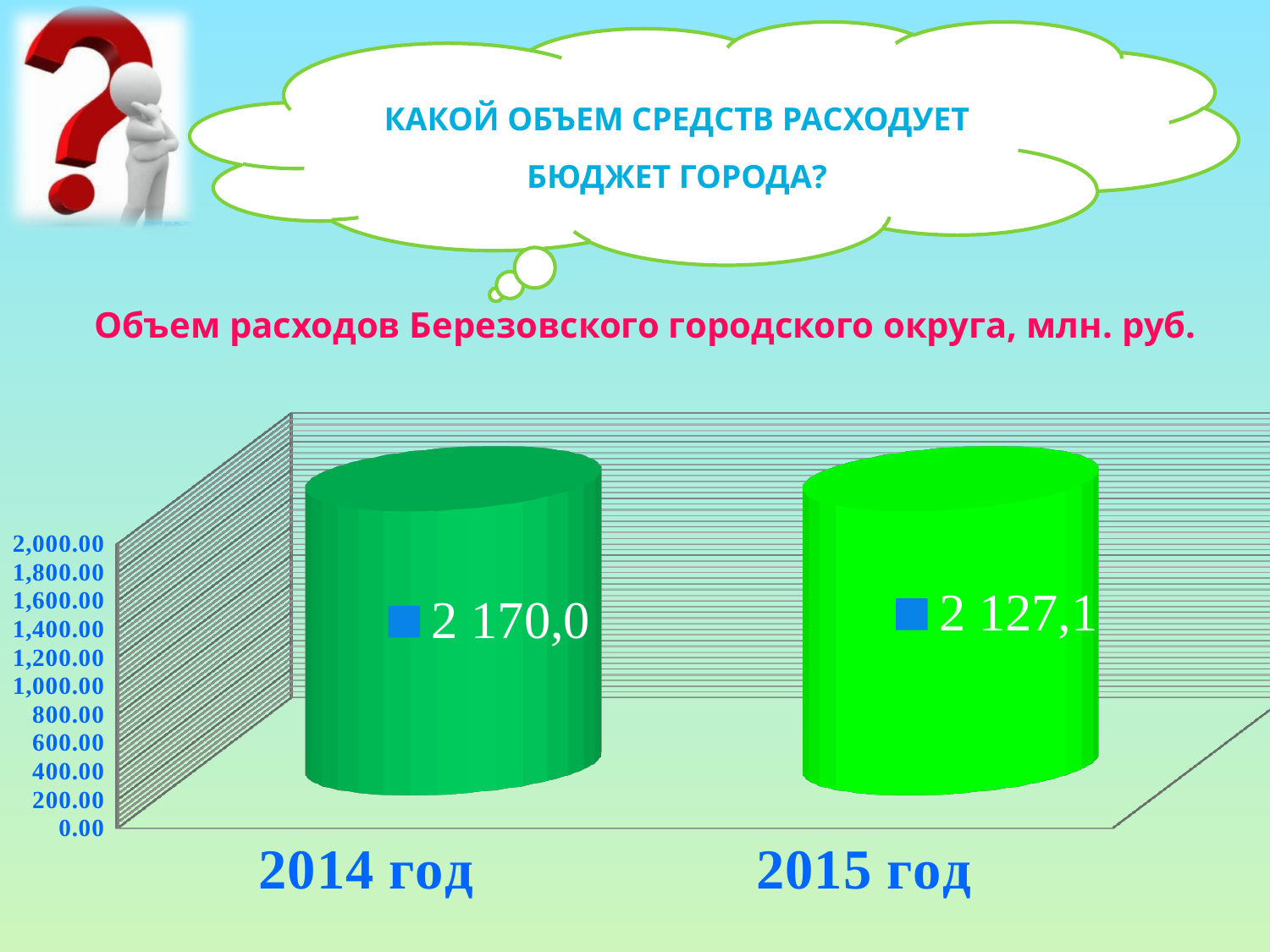
Do the values rise or fall from 2014 год to 2015 год? fall What is the title of the chart? Объем расходов Березовского городского округа, млн. руб. What is the value for 2014 год? 2 170,0 What kind of chart is shown on the slide? bar chart Is the value for 2014 год greater or less than 2,000.00? greater How many categories are shown on the chart? 2 What is the highest value shown on the vertical axis? 2,000.00 Is the value for 2015 год larger or smaller than the value for 2014 год? smaller Which year has the higher value? 2014 год What is the difference between the values for 2014 год and 2015 год? 42,9 What is the value for 2015 год? 2 127,1 Which year has the lower value? 2015 год